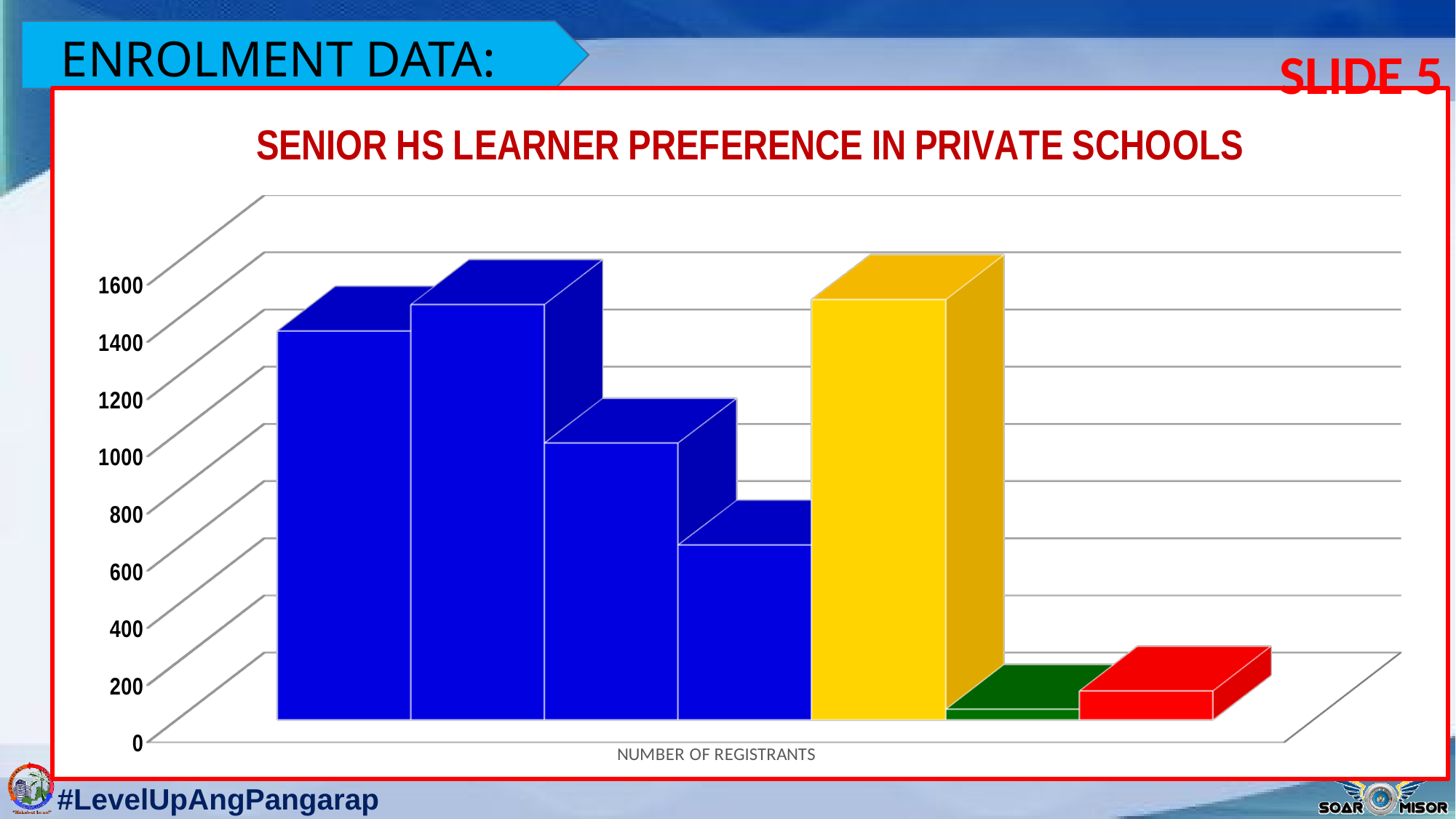
How many bars are plotted in the chart? 7 What is the title of the chart? SENIOR HS LEARNER PREFERENCE IN PRIVATE SCHOOLS Which bar is the lowest in the chart? the green bar Is the value of the yellow bar greater or less than 1200? greater Is the value of the green bar greater or less than 200? less Is the value of the first (leftmost) blue bar greater or less than 1000? greater Which is larger, the red bar or the green bar? the red bar What label appears under the horizontal axis of the chart? NUMBER OF REGISTRANTS Which is larger, the first blue bar or the third blue bar? the first blue bar What kind of chart is shown on the slide? bar chart